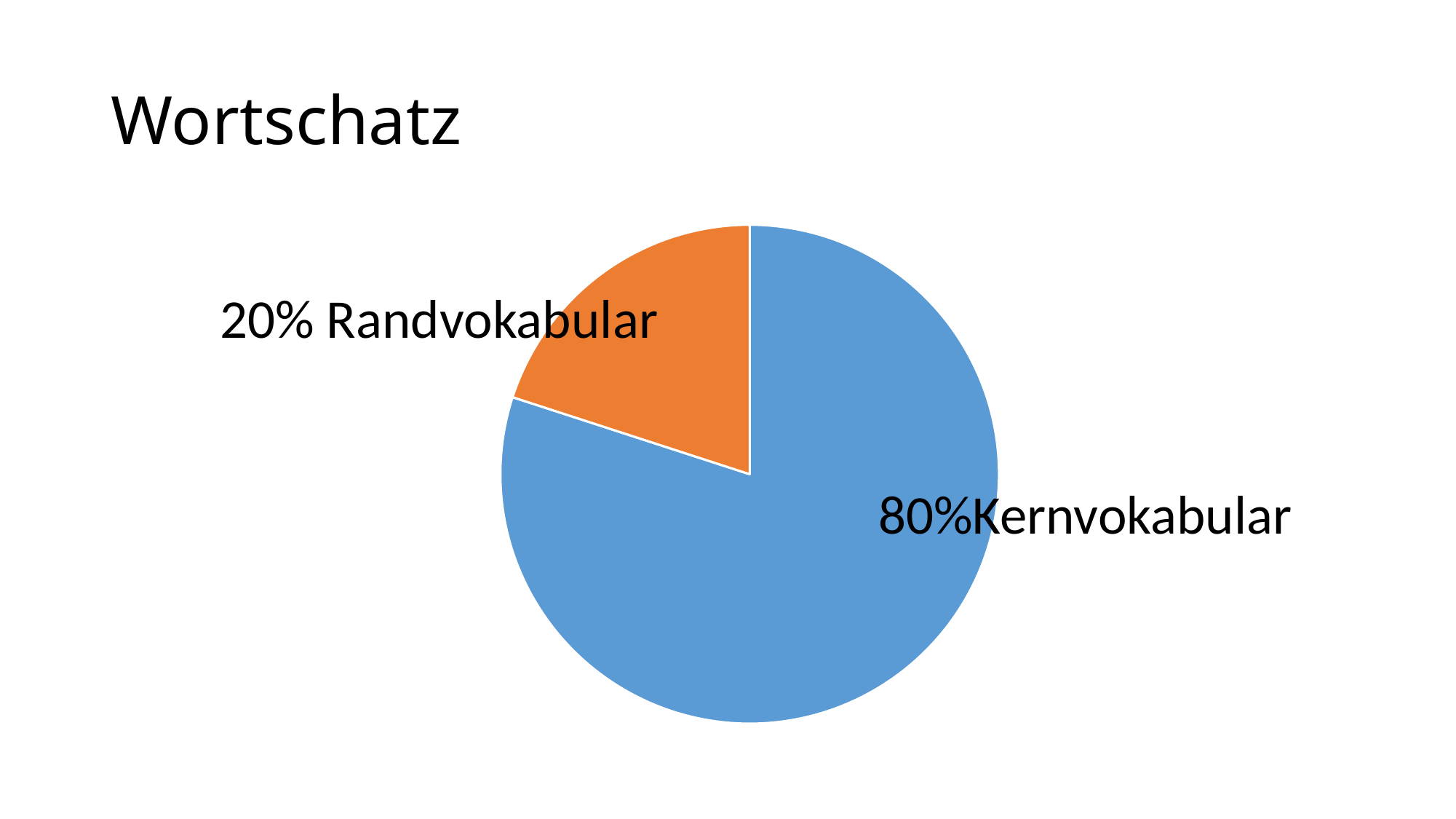
What is the difference in percentage points between Kernvokabular and Randvokabular? 60 What is the total of the two slices' percentages? 100% What share of the pie does Kernvokabular take? 80% Which is larger, Kernvokabular or Randvokabular? Kernvokabular How many slices does the pie chart have? 2 What share of the pie does Randvokabular take? 20% What kind of chart is shown on the slide? pie chart What colour is the Randvokabular slice? orange What is the title of the chart? Wortschatz Which slice is the largest? Kernvokabular Which slice is the smallest? Randvokabular